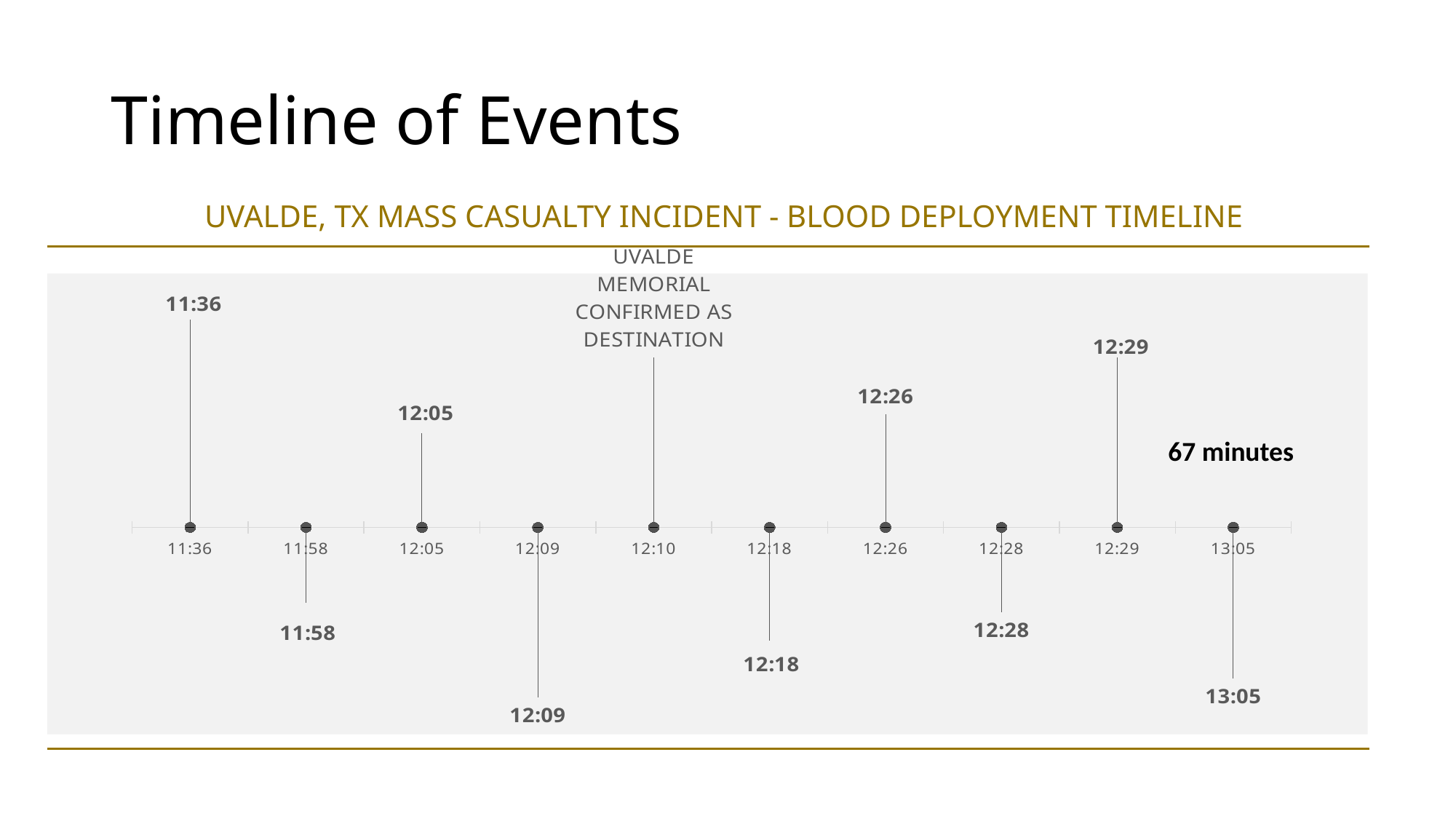
At what time was Uvalde Memorial confirmed as destination? 12:10 How many events are marked on the timeline? 10 Which time comes immediately before 13:05 on the timeline? 12:29 What is the earliest time marked on the timeline? 11:36 How many minutes elapse between 11:58 and 13:05 on the timeline? 67 minutes What is the title of the chart? UVALDE, TX MASS CASUALTY INCIDENT - BLOOD DEPLOYMENT TIMELINE What duration is annotated on the right side of the chart? 67 minutes What is the latest time marked on the timeline? 13:05 What kind of chart is shown on the slide? Timeline chart Do the times on the timeline increase or decrease from left to right? Increase Which event on the timeline is labelled with a description rather than just a time? 12:10 (Uvalde Memorial confirmed as destination) Which time comes immediately after 12:09 on the timeline? 12:10